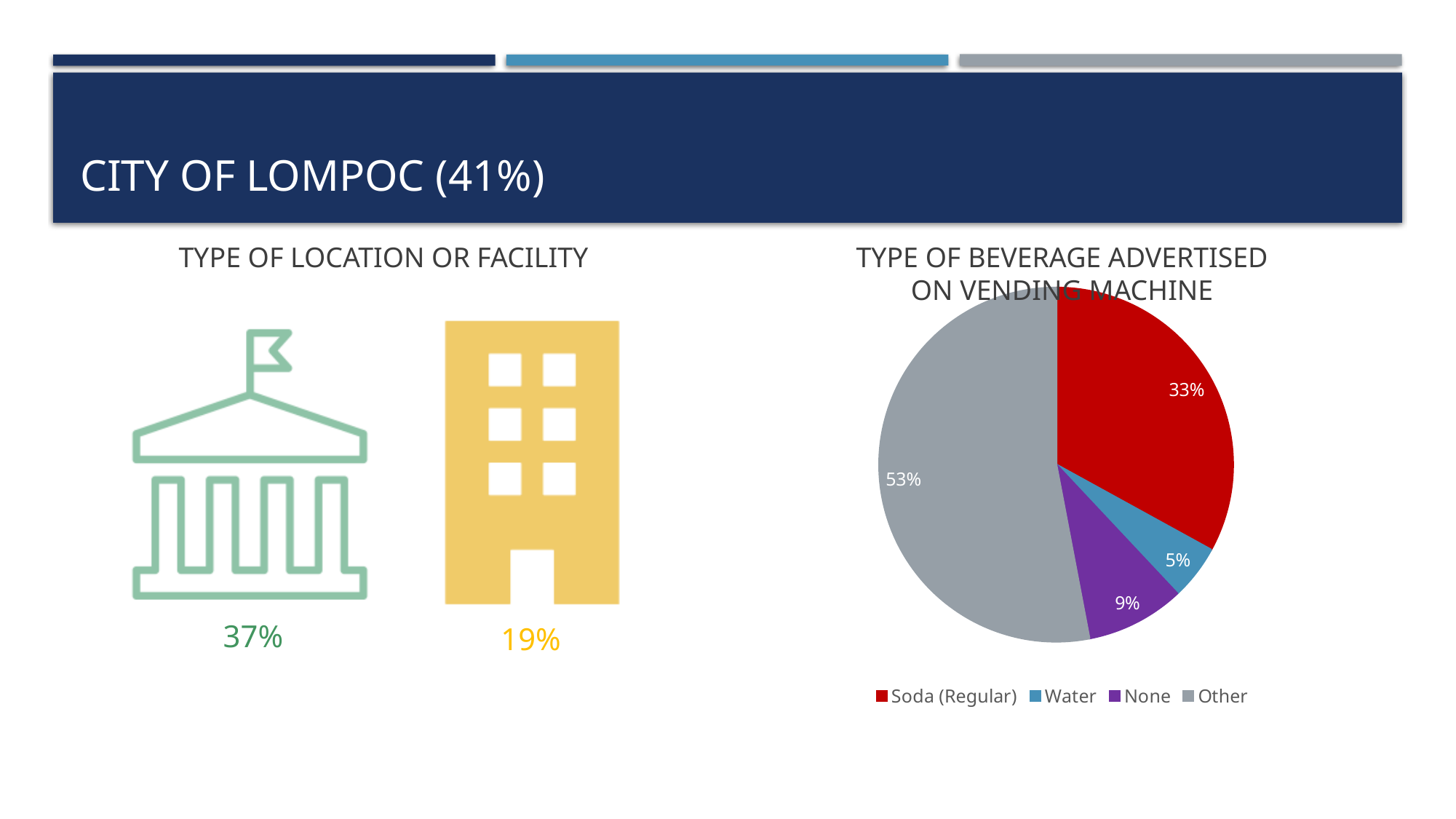
In the 'Type of Beverage Advertised on Vending Machine' chart, what colour is the Soda (Regular) slice? red In the 'Type of Beverage Advertised on Vending Machine' chart, what kind of chart is shown? pie chart In the 'Type of Beverage Advertised on Vending Machine' chart, what share does Soda (Regular) have? 33% In the 'Type of Beverage Advertised on Vending Machine' chart, what share does Other have? 53% In the 'Type of Beverage Advertised on Vending Machine' chart, what share does None have? 9% In the 'Type of Beverage Advertised on Vending Machine' chart, how many categories does the legend list? 4 In the 'Type of Beverage Advertised on Vending Machine' chart, which category has the largest slice? Other In the 'Type of Beverage Advertised on Vending Machine' chart, which is larger, None or Water? None In the 'Type of Beverage Advertised on Vending Machine' chart, what is the difference between the Other and Soda (Regular) shares? 20% In the 'Type of Beverage Advertised on Vending Machine' chart, what share does Water have? 5% In the 'Type of Beverage Advertised on Vending Machine' chart, what is the combined share of Soda (Regular) and Water? 38% In the 'Type of Beverage Advertised on Vending Machine' chart, which category has the smallest slice? Water